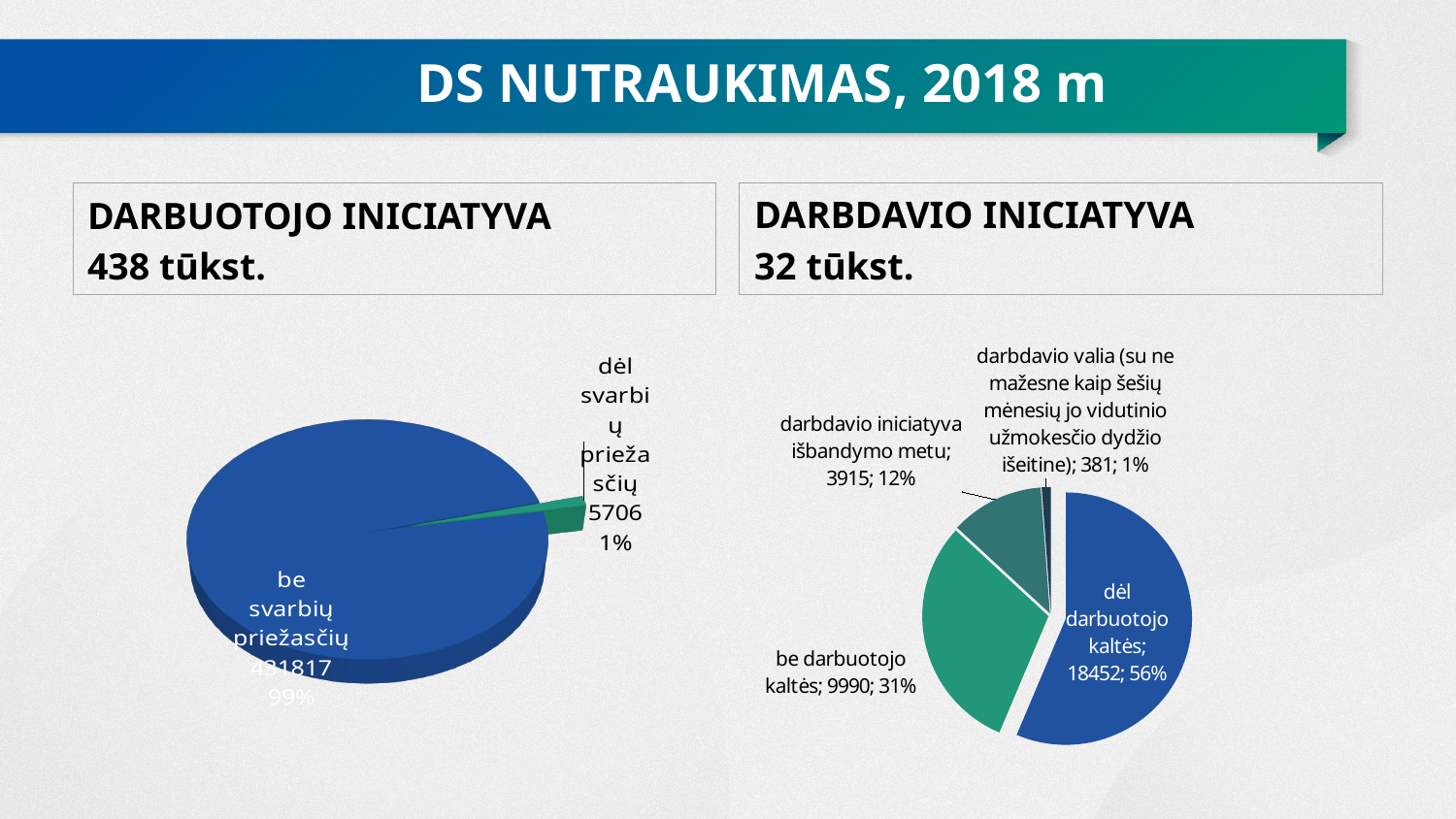
In the left pie chart (DARBUOTOJO INICIATYVA), what share of the pie is 'dėl svarbių priežasčių'? 1% In the left pie chart (DARBUOTOJO INICIATYVA), what is the value for 'dėl svarbių priežasčių'? 5706 In the right pie chart (DARBDAVIO INICIATYVA), which category has the smallest slice? darbdavio valia (su ne mažesne kaip šešių mėnesių jo vidutinio užmokesčio dydžio išeitine) What kind of chart is shown under the heading DARBUOTOJO INICIATYVA on the left? pie chart In the left pie chart (DARBUOTOJO INICIATYVA), what is the value for 'be svarbių priežasčių'? 431817 In the right pie chart (DARBDAVIO INICIATYVA), what is the difference between the values for 'dėl darbuotojo kaltės' and 'be darbuotojo kaltės'? 8462 In the right pie chart (DARBDAVIO INICIATYVA), which category has the largest slice? dėl darbuotojo kaltės In the right pie chart (DARBDAVIO INICIATYVA), what share of the pie is 'be darbuotojo kaltės'? 31% How many slices does the right pie chart (DARBDAVIO INICIATYVA) have? 4 In the right pie chart (DARBDAVIO INICIATYVA), what is the value for 'darbdavio iniciatyva išbandymo metu'? 3915 How many slices does the left pie chart (DARBUOTOJO INICIATYVA) have? 2 In the right pie chart (DARBDAVIO INICIATYVA), what is the value for 'dėl darbuotojo kaltės'? 18452